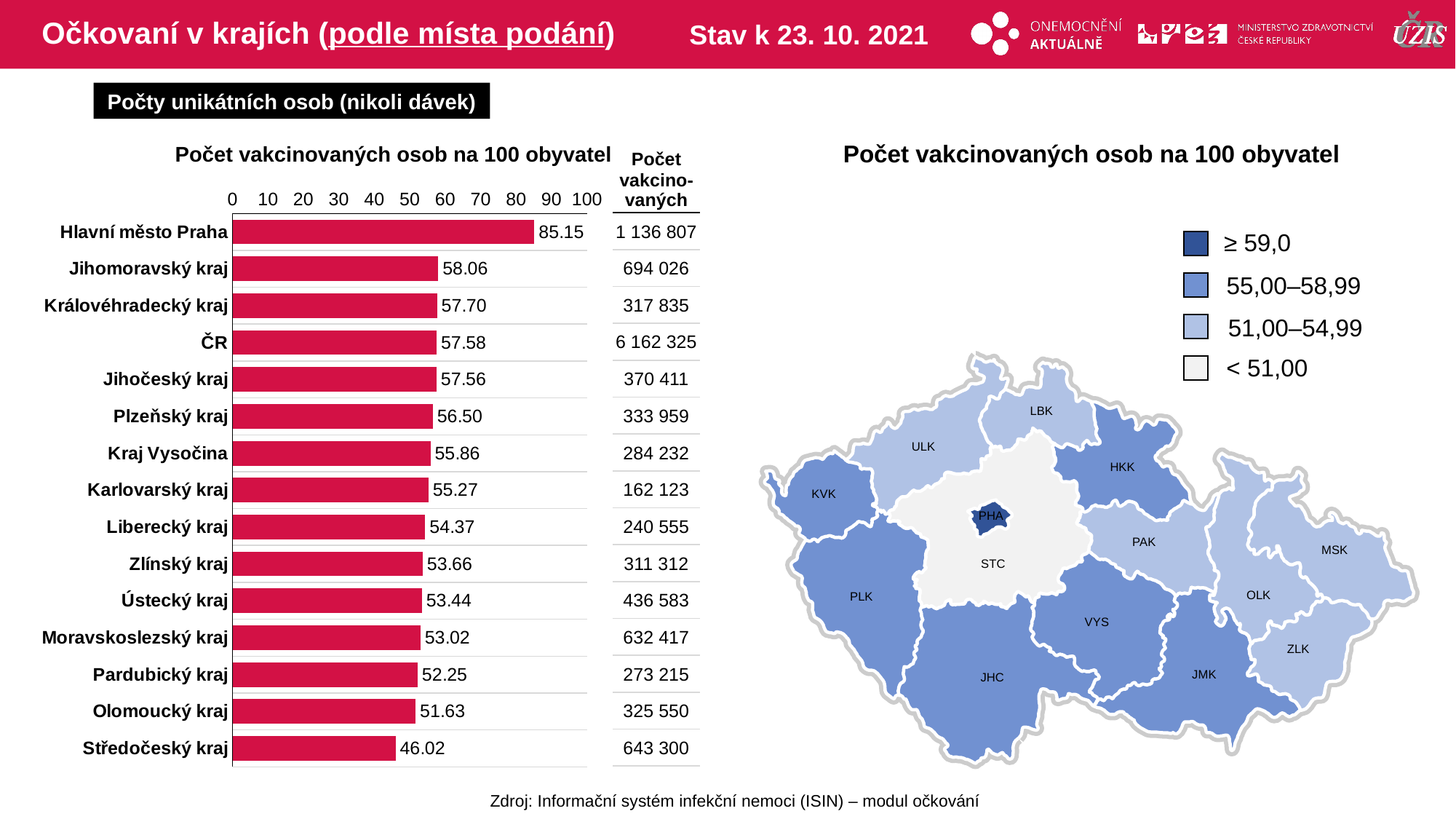
In the bar chart, which region has the lowest number of vaccinated persons per 100 inhabitants? Středočeský kraj In the bar chart, which has a larger value, Plzeňský kraj or Liberecký kraj? Plzeňský kraj In the bar chart, which region has the highest number of vaccinated persons per 100 inhabitants? Hlavní město Praha What type of chart is used on the left side of the slide to show vaccinated persons per 100 inhabitants? bar chart How many bars are shown in the bar chart? 15 How many categories does the legend of the map on the right list? 4 In the bar chart, what is the value for ČR? 57.58 In the bar chart, what is the difference between the values for Jihomoravský kraj and Olomoucký kraj? 6.43 In the bar chart, is the value for Středočeský kraj greater or less than 50? less In the bar chart, what is the value for Kraj Vysočina? 55.86 In the bar chart, what is the number of vaccinated persons per 100 inhabitants for Hlavní město Praha? 85.15 In the bar chart, what is the difference between the values for Hlavní město Praha and Středočeský kraj? 39.13